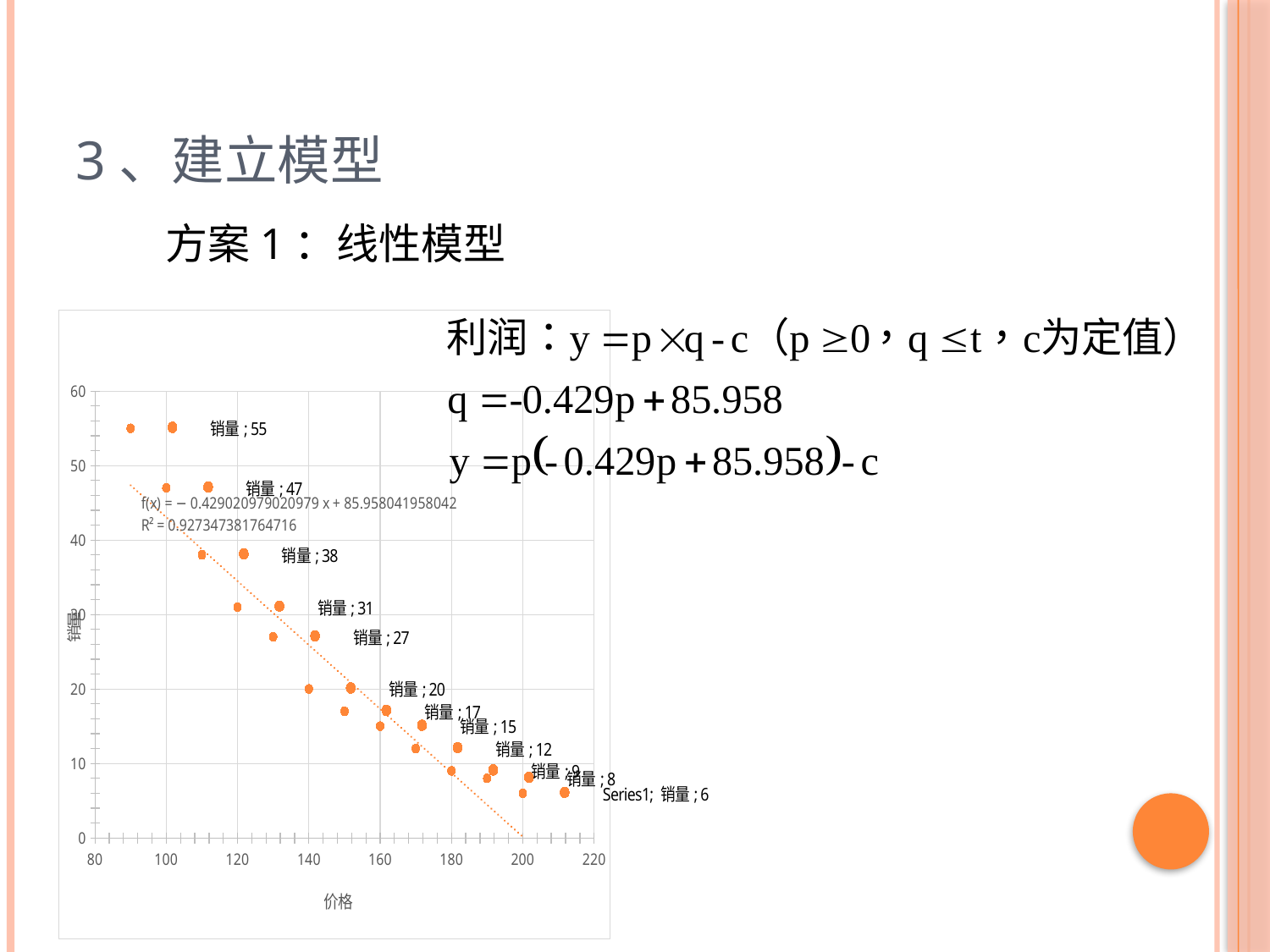
What is the highest 销量 value labelled on the chart? 55 What R² value is printed on the chart for the trendline? 0.927347381764716 Is the 销量 value for the point at 价格 90 greater or less than 50? greater Is the 销量 value for the point at 价格 210 greater or less than 10? less What kind of chart is shown on the slide? scatter chart What is the largest tick value shown on the x axis of the chart? 220 Which labelled value is larger, 销量; 38 or 销量; 31? 销量; 38 As 价格 increases along the x axis, do the 销量 values rise or fall? fall What is the difference between the labelled values 销量; 20 and 销量; 12? 8 What is the lowest 销量 value labelled on the chart? 6 What is the difference between the labelled values 销量; 55 and 销量; 47? 8 What is the title of the x axis of the chart? 价格